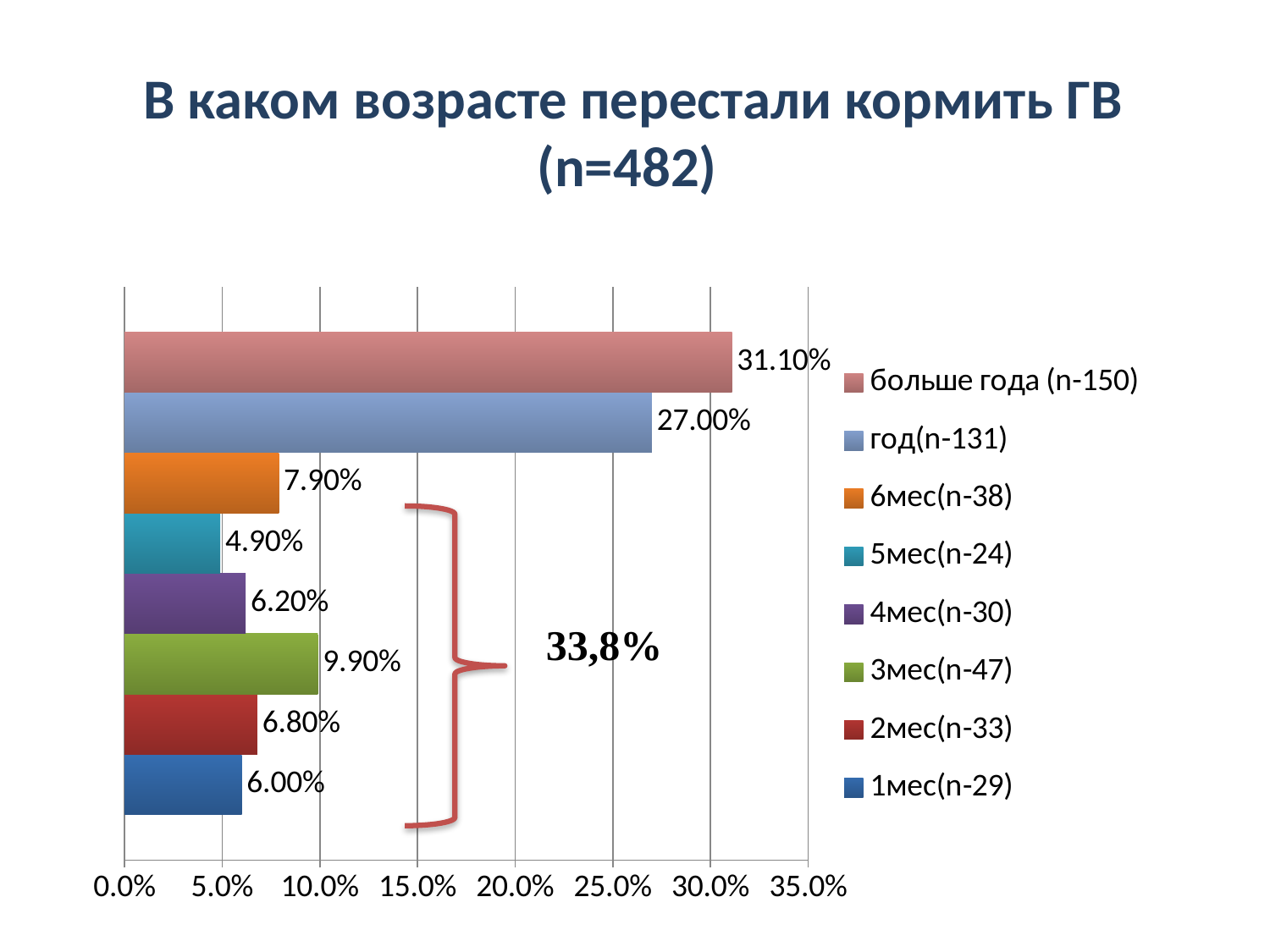
How many categories does the legend list? 8 Which category has the lowest value? 5мес(n-24) What is the value for "5мес(n-24)"? 4.90% What is the value for "1мес(n-29)"? 6.00% What percentage is written next to the bracket grouping the 1–6 month bars? 33,8% What is the value for "3мес(n-47)"? 9.90% What kind of chart is shown on the slide? bar chart Is the value for "год(n-131)" greater or less than 25.0%? greater What is the difference between the values for "больше года (n-150)" and "год(n-131)"? 4.10% Which is larger, the value for "2мес(n-33)" or the value for "4мес(n-30)"? 2мес(n-33) What is the value for "больше года (n-150)"? 31.10% Which category has the highest value? больше года (n-150)